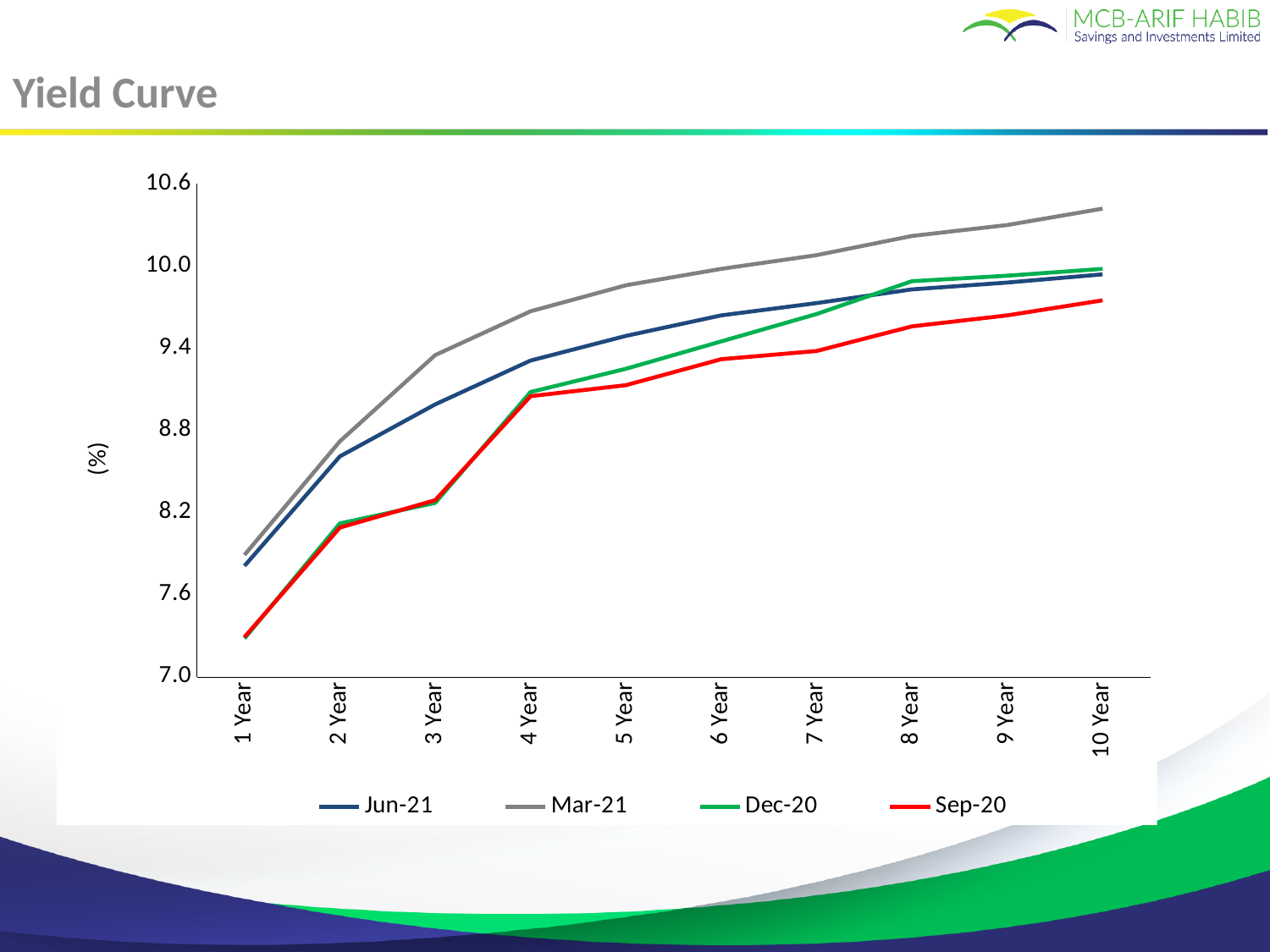
At 3 Year, which is larger: the Mar-21 yield or the Jun-21 yield? Mar-21 How many maturity categories are shown on the x axis? 10 Do the Mar-21 yields rise or fall as maturity increases from 1 Year to 10 Year? Rise At 8 Year, which is larger: the Dec-20 yield or the Sep-20 yield? Dec-20 Is the Sep-20 yield at 1 Year greater or less than 7.6? less Which series has the highest yield at 10 Year? Mar-21 Is the Mar-21 yield at 10 Year greater or less than 10.0? greater What kind of chart is shown on the slide? Line chart How many series does the legend list? 4 What is the title of the chart? Yield Curve Is the Jun-21 yield at 3 Year greater or less than 8.8? greater Which series has the lowest yield at 10 Year? Sep-20